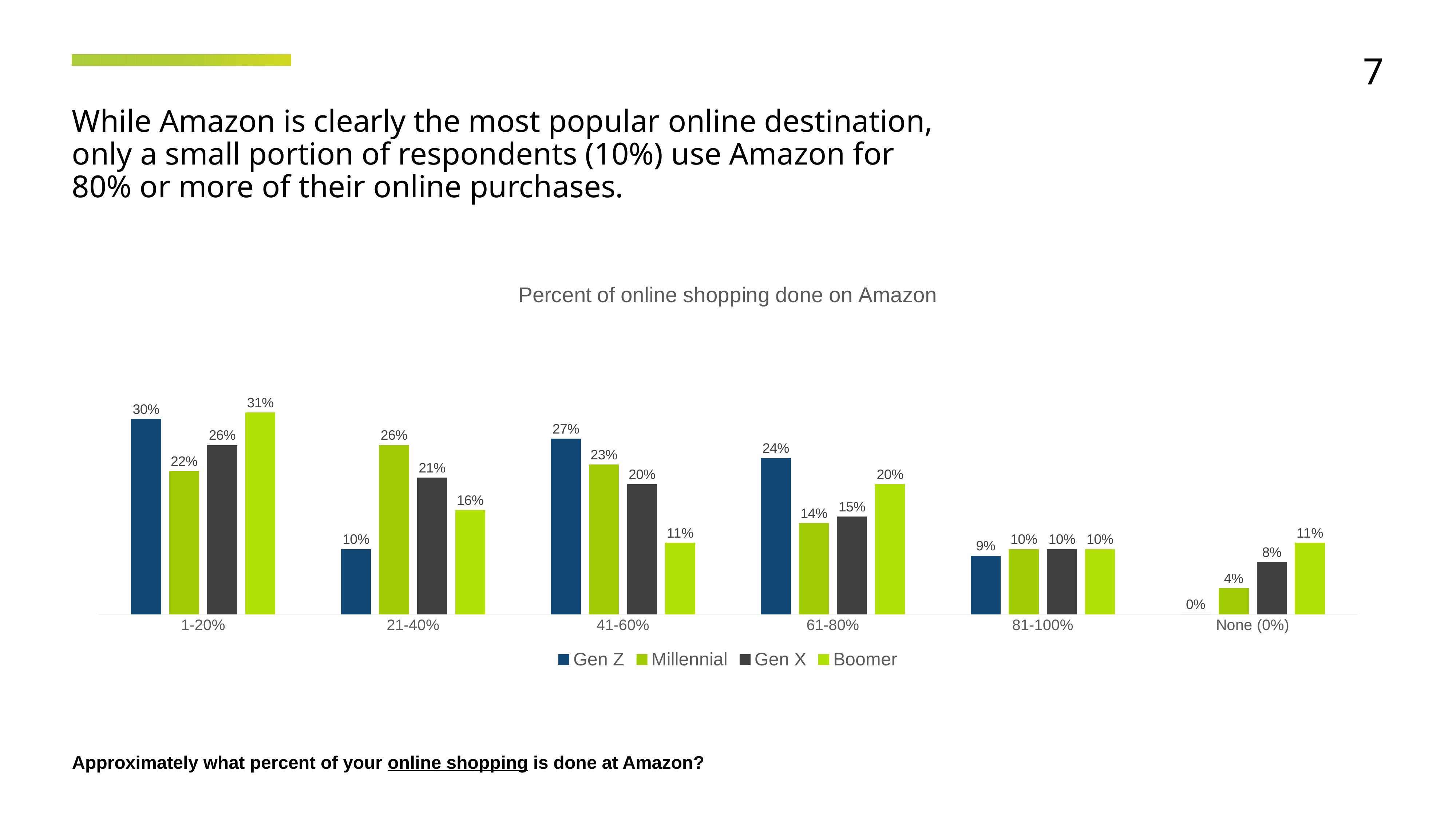
What is the value for Gen Z in the 1-20% category? 30% What is the difference between the Gen Z and Millennial values in the 21-40% category? 16% What kind of chart is shown? Bar chart Which series is shown in dark blue? Gen Z What is the value for Millennial in the None (0%) category? 4% Which category has the lowest value for Gen Z? None (0%) In the 41-60% category, which is larger, Gen Z or Boomer? Gen Z How many categories are shown on the x axis? 6 Which category has the highest value for Gen Z? 1-20% What is the value for Boomer in the 61-80% category? 20% What is the title of the chart? Percent of online shopping done on Amazon How many series does the legend list? 4